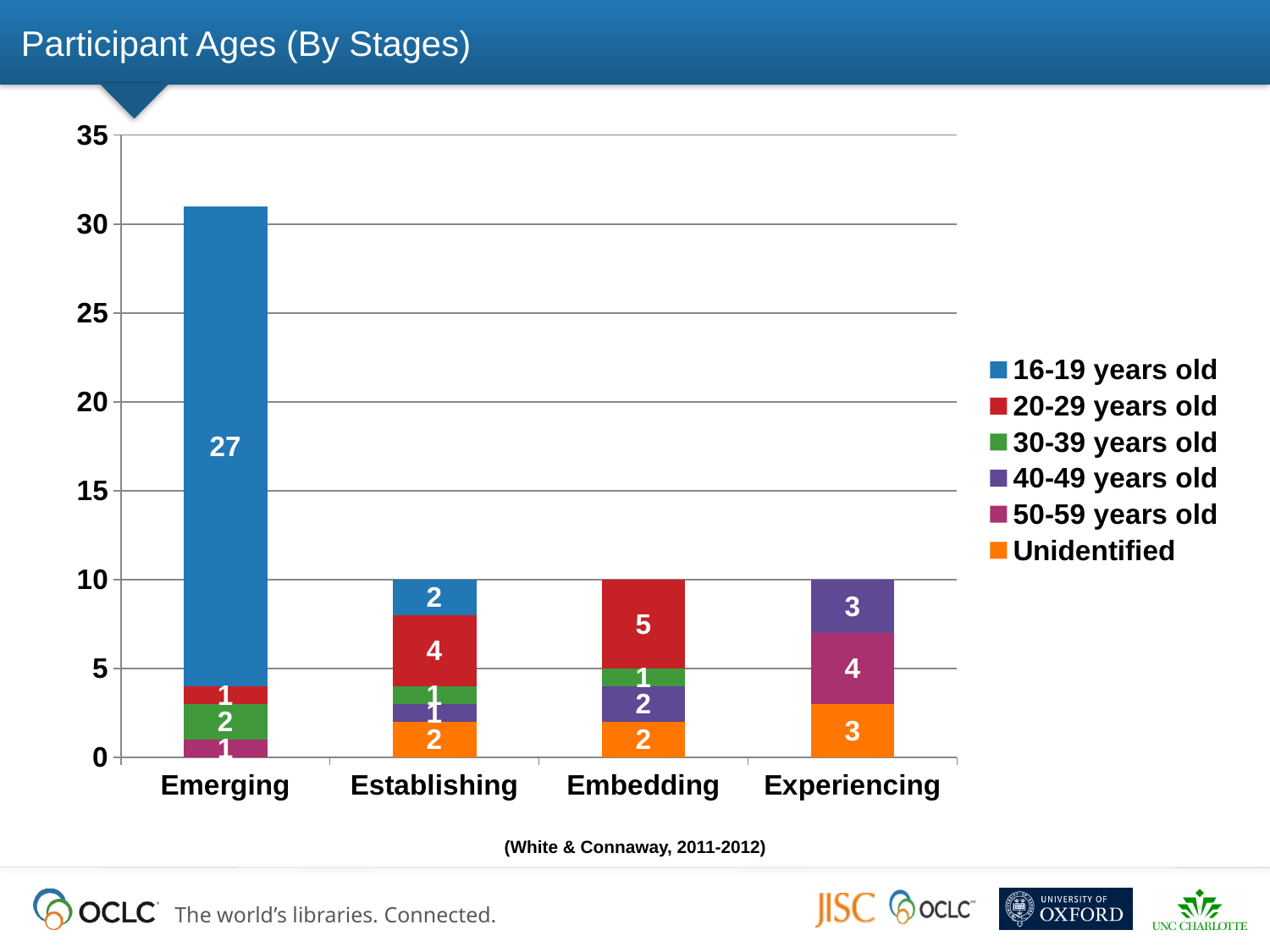
How many participants aged 16-19 years old are in the Emerging stage? 27 How many series does the legend list? 6 What is the total of the stacked bar for the Emerging stage? 31 What is the value for 50-59 years old in the Experiencing stage? 4 What is the value for Unidentified in the Establishing stage? 2 How many stages are shown on the x axis? 4 What is the difference between the 20-29 years old values for Embedding and Establishing? 1 Is the total for the Emerging stage greater or less than 30? greater Which is larger: the 40-49 years old value for Experiencing or for Embedding? Experiencing What is the total of the stacked bar for the Establishing stage? 10 What is the value for 20-29 years old in the Embedding stage? 5 Which stage has the tallest stacked bar? Emerging